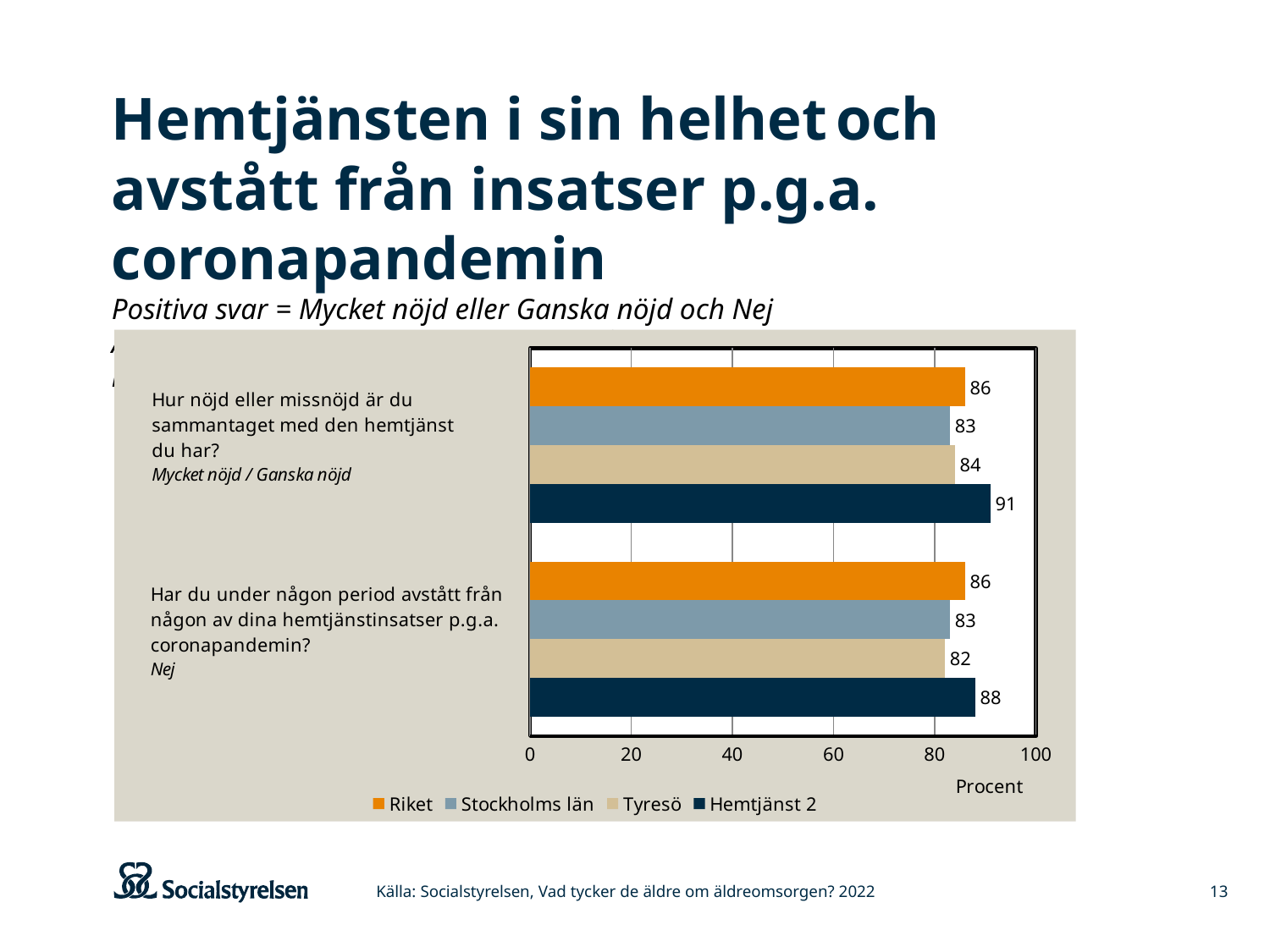
What is the value for Stockholms län on the question "Hur nöjd eller missnöjd är du sammantaget med den hemtjänst du har?"? 83 Which is larger on the question "Hur nöjd eller missnöjd är du sammantaget med den hemtjänst du har?": Tyresö or Riket? Riket What is the label of the horizontal axis? Procent What is the difference between Hemtjänst 2 and Tyresö on the question "Har du under någon period avstått från någon av dina hemtjänstinsatser p.g.a. coronapandemin?"? 6 Which series has the lowest value on the question "Hur nöjd eller missnöjd är du sammantaget med den hemtjänst du har?"? Stockholms län What kind of chart is shown on the slide? Bar chart What is the value for Hemtjänst 2 on the question "Hur nöjd eller missnöjd är du sammantaget med den hemtjänst du har?"? 91 How many series does the legend list? 4 Which series has the highest value on the question "Har du under någon period avstått från någon av dina hemtjänstinsatser p.g.a. coronapandemin?"? Hemtjänst 2 What is the value for Tyresö on the question "Har du under någon period avstått från någon av dina hemtjänstinsatser p.g.a. coronapandemin?"? 82 What is the difference between Hemtjänst 2 and Riket on the question "Hur nöjd eller missnöjd är du sammantaget med den hemtjänst du har?"? 5 How many question categories are shown on the chart? 2